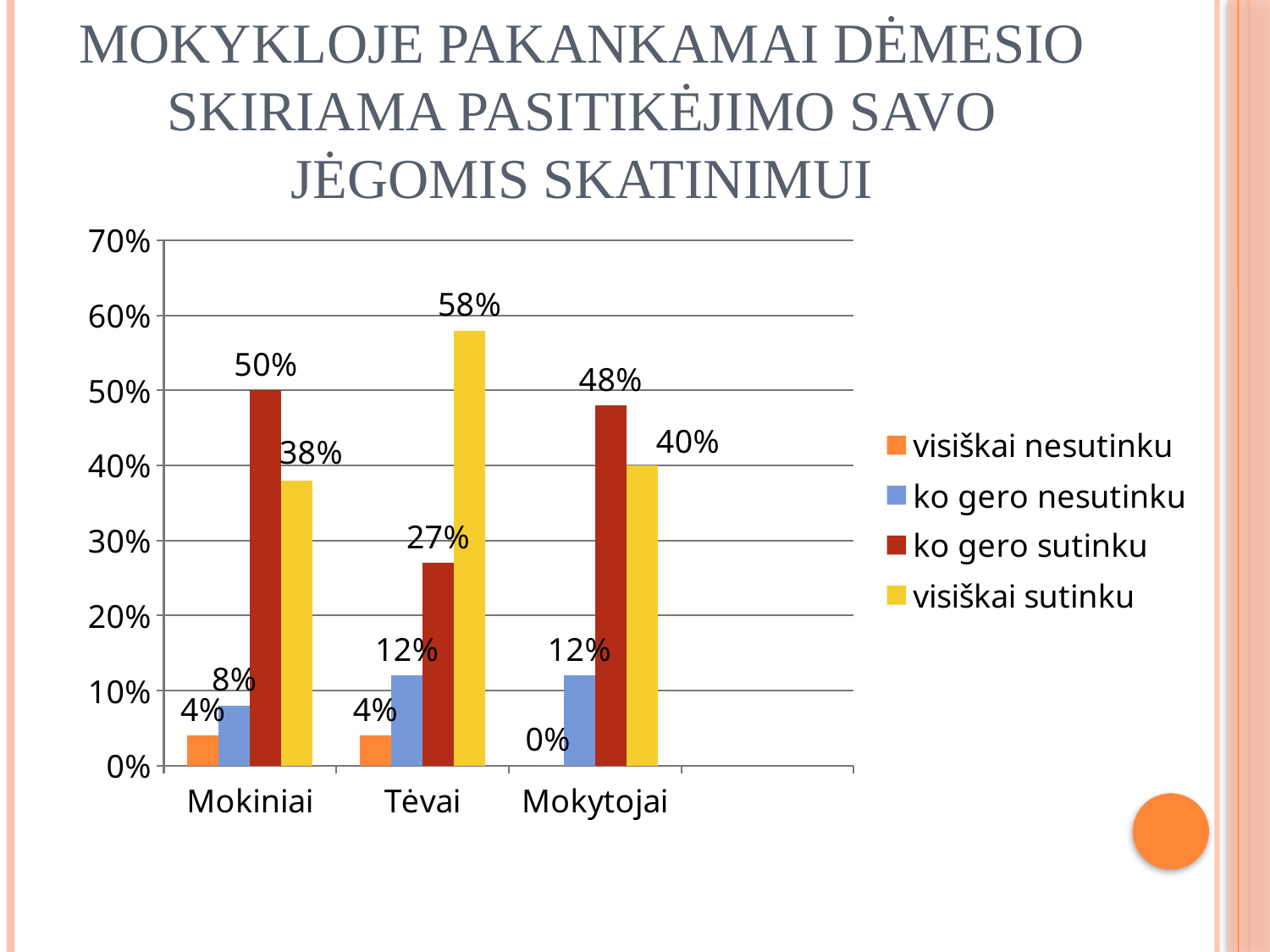
Which is larger in the Mokytojai category: 'ko gero sutinku' or 'visiškai sutinku'? ko gero sutinku What is the value for 'visiškai nesutinku' in the Mokytojai category? 0% How many series does the legend list? 4 How many categories are shown on the x axis? 3 Which category has the lowest value for 'ko gero sutinku'? Tėvai What is the value for 'ko gero nesutinku' in the Tėvai category? 12% Which category has the highest value for 'visiškai sutinku'? Tėvai What is the difference between 'ko gero sutinku' and 'visiškai sutinku' in the Mokiniai category? 12% Which colour represents 'visiškai sutinku' in the legend? yellow What is the value for 'ko gero sutinku' in the Mokiniai category? 50% What kind of chart is shown on the slide? bar chart What is the value for 'visiškai sutinku' in the Tėvai category? 58%